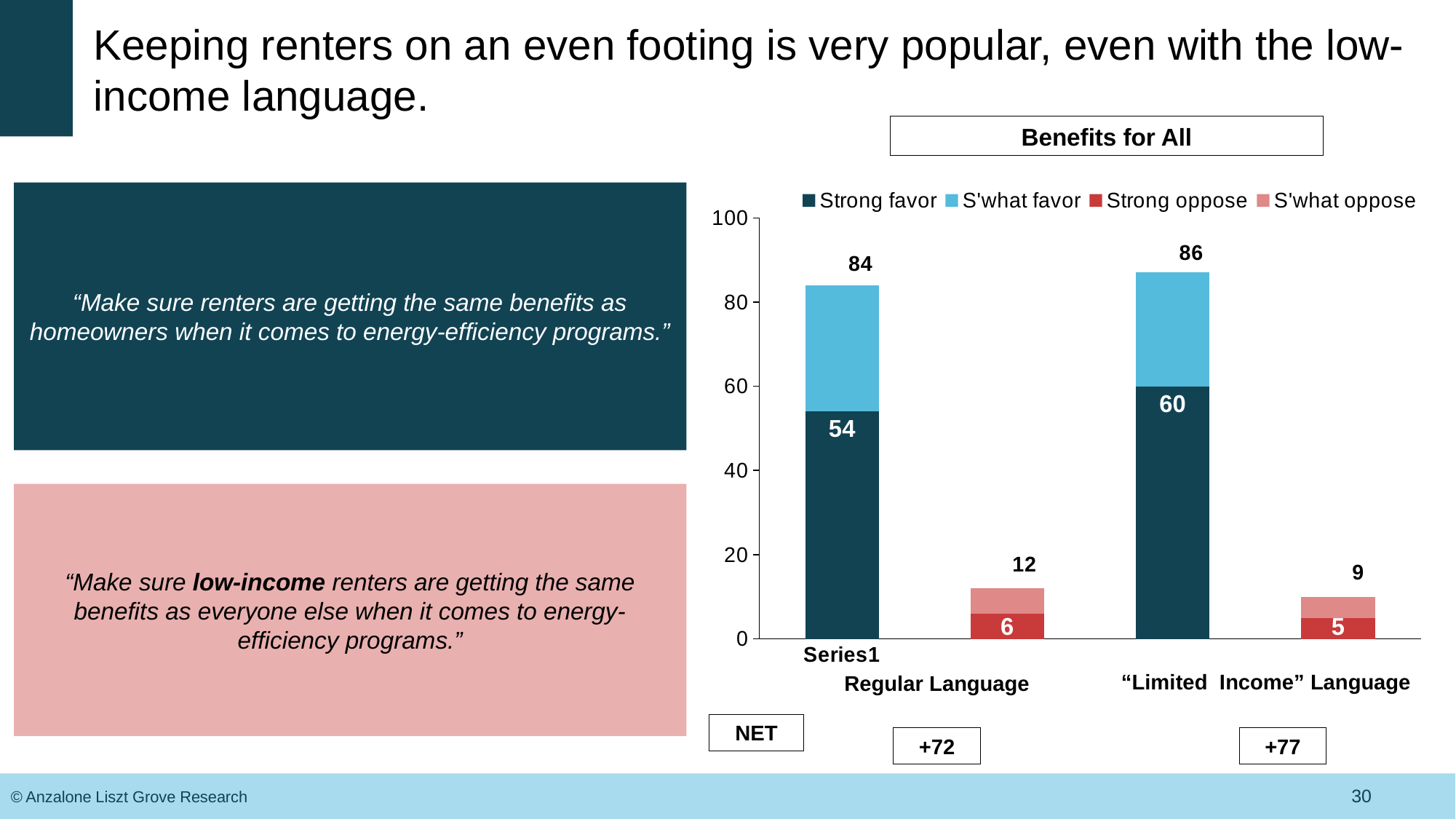
What kind of chart is shown under the title "Benefits for All"? Stacked bar chart How many series does the legend of the "Benefits for All" chart list? 4 What is the NET value shown for "Limited Income" Language? +77 What is the total oppose for "Limited Income" Language? 9 What is the total favor (Strong favor plus S'what favor) for "Limited Income" Language? 86 What is the total favor (Strong favor plus S'what favor) for Regular Language? 84 What is the Strong favor value for Regular Language? 54 Which language version has the higher Strong favor value? "Limited Income" Language What is the Strong favor value for "Limited Income" Language? 60 What is the difference between the total favor and the Strong favor value for Regular Language? 30 Is the total favor bar for Regular Language greater or less than 80? greater What is the Strong oppose value for Regular Language? 6